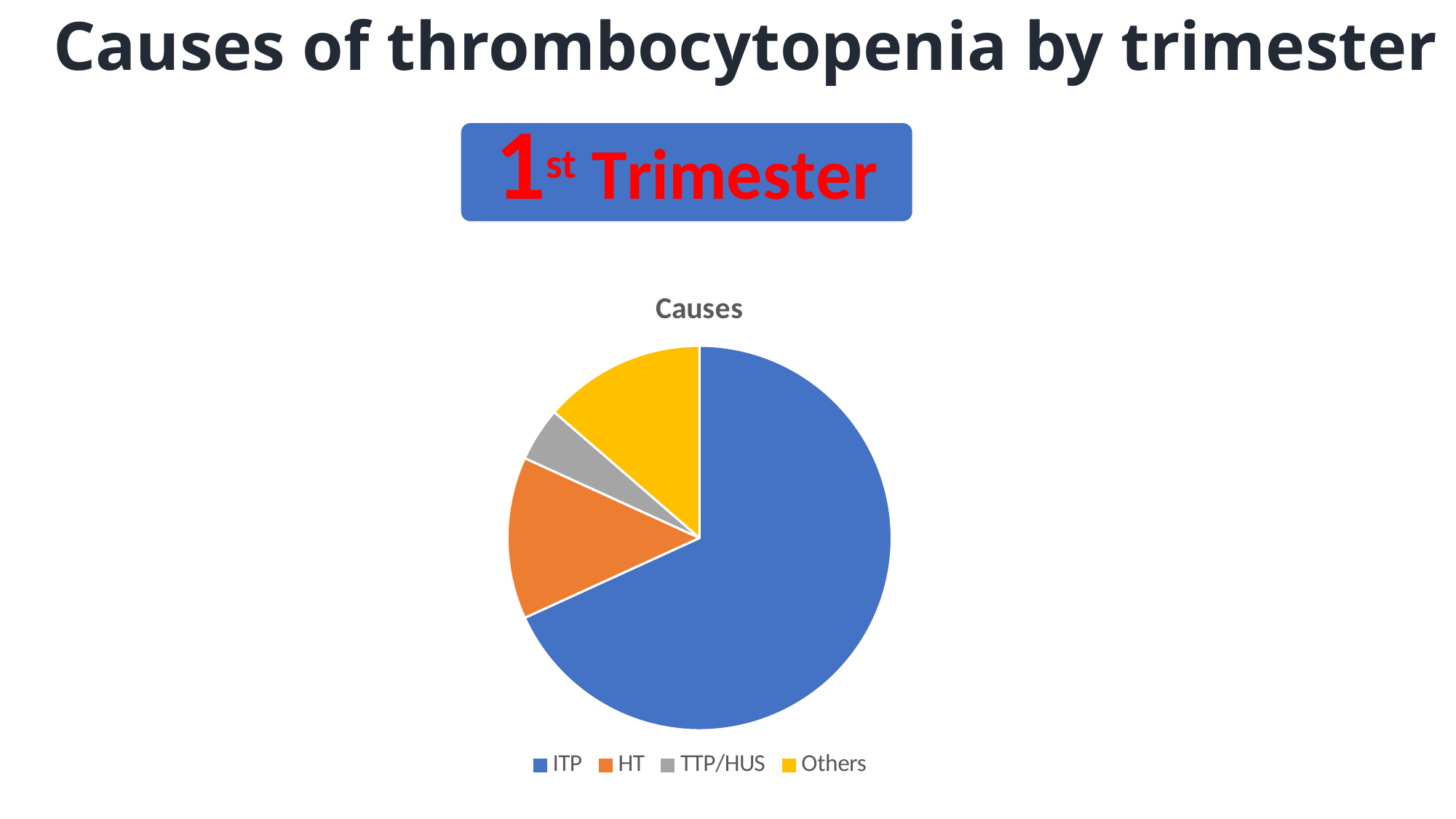
What colour is the ITP slice? blue What kind of chart is shown on the slide? pie chart Which category has the largest slice of the pie? ITP Which category has the smallest slice of the pie? TTP/HUS What is the title of the chart? Causes Which category is shown in yellow? Others Which slice is larger, ITP or Others? ITP Which slice is larger, Others or TTP/HUS? Others Which slice is larger, HT or TTP/HUS? HT How many categories does the pie chart show? 4